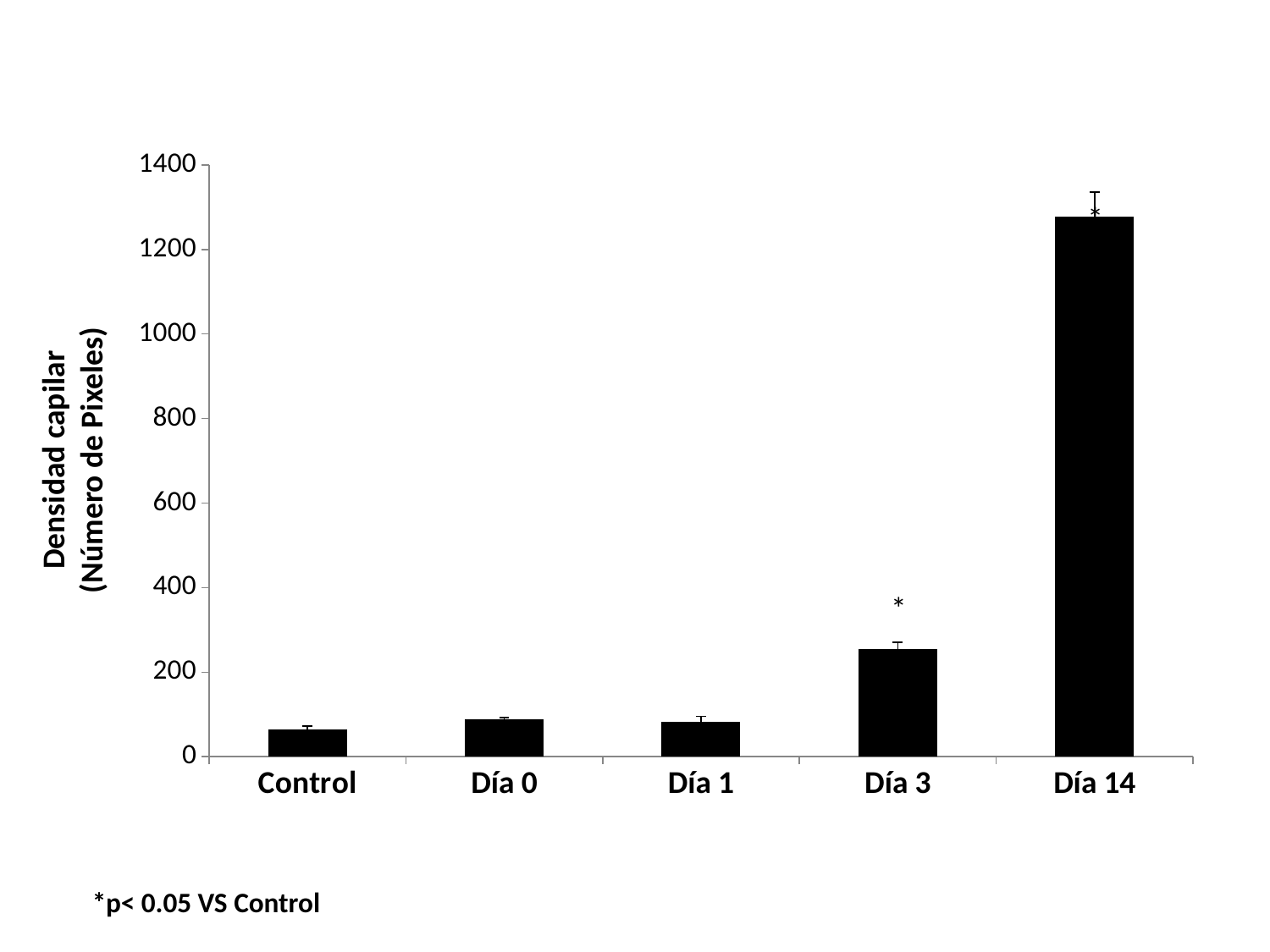
Is the value for Día 3 greater or less than 200? greater What is the label of the y axis? Densidad capilar (Número de Pixeles) Is the value for Día 3 greater or less than 400? less Which category has the highest capillary density? Día 14 What kind of chart is shown on the slide? bar chart How many categories are shown on the x axis? 5 Do the values generally rise or fall from Control to Día 14 along the x axis? rise Which is larger, the value for Día 14 or the value for Día 3? Día 14 Which is larger, the value for Día 3 or the value for Día 1? Día 3 Is the value for Control greater or less than 200? less